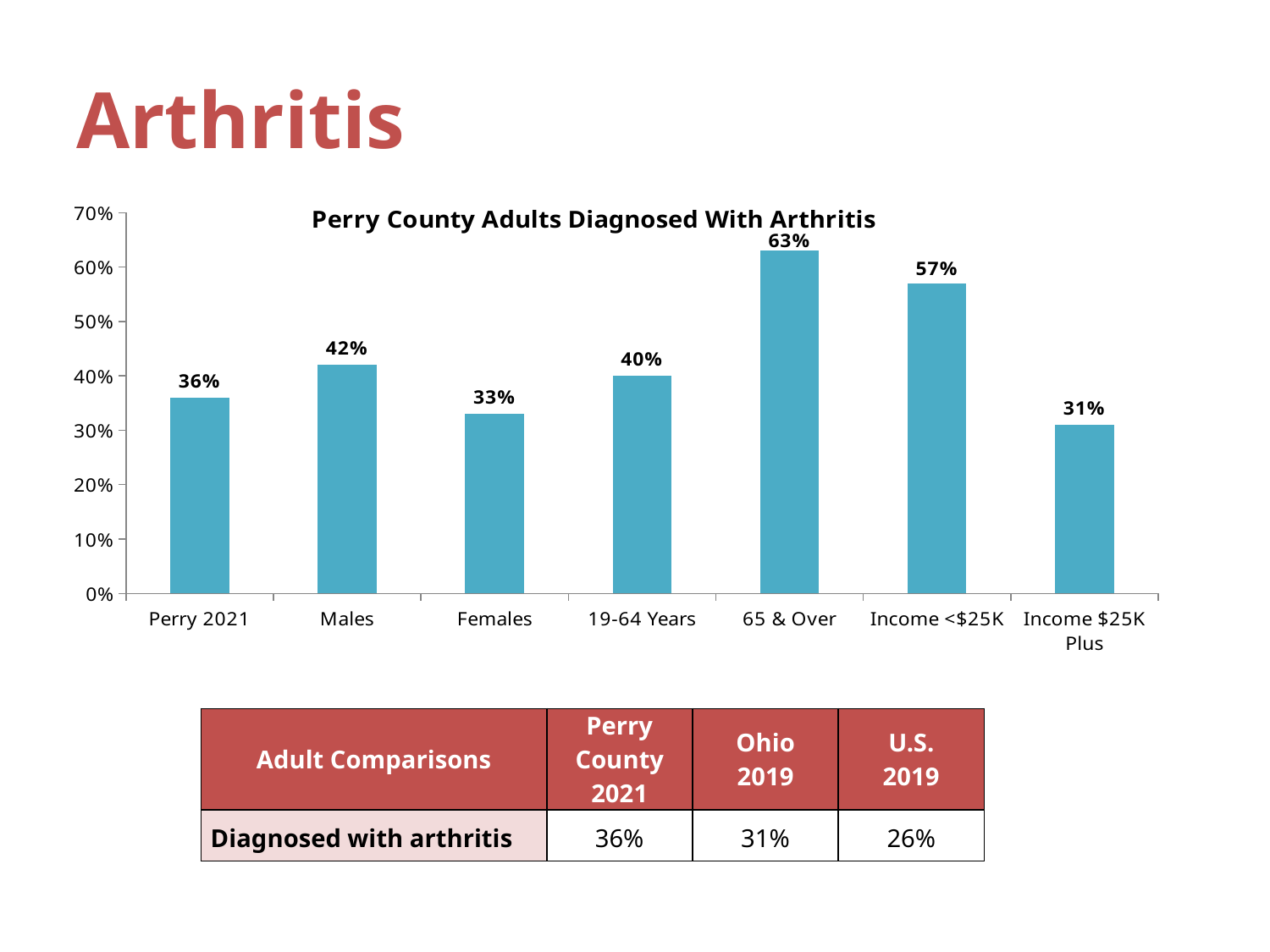
Which category has the lowest value in the chart? Income $25K Plus What is the title of the chart? Perry County Adults Diagnosed With Arthritis What is the value for Perry 2021 in the chart? 36% How many categories are shown in the chart? 7 What is the value for Income <$25K in the chart? 57% What is the value for Males in the chart? 42% Which is larger, the value for Income <$25K or the value for Income $25K Plus? Income <$25K What is the difference between the values for Males and Females? 9% What kind of chart is shown on the slide? bar chart Which category has the highest value in the chart? 65 & Over Is the value for 65 & Over greater or less than 60%? greater What is the difference between the values for 65 & Over and 19-64 Years? 23%